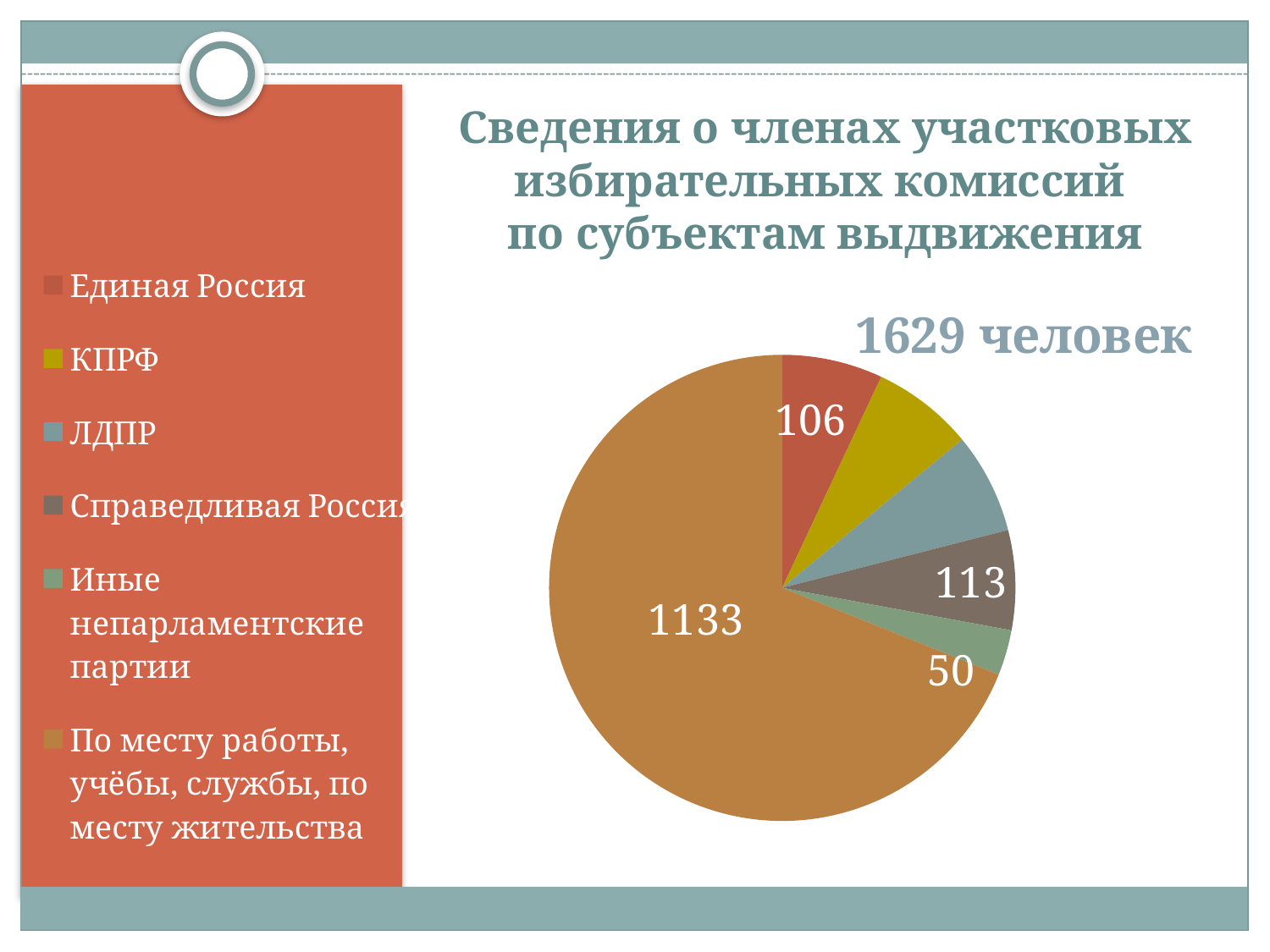
What is the value for Единая Россия in the pie chart? 106 Which category has the largest slice in the pie chart? По месту работы, учёбы, службы, по месту жительства Which is larger: the value for Единая Россия or the value for Иные непарламентские партии? Единая Россия Which category has the smallest slice in the pie chart? Иные непарламентские партии What colour is the slice for КПРФ in the pie chart? yellow What is the value for Справедливая Россия in the pie chart? 113 What total number of people is stated next to the pie chart? 1629 человек What type of chart is shown on the slide? pie chart What is the value for По месту работы, учёбы, службы, по месту жительства in the pie chart? 1133 What is the value for Иные непарламентские партии in the pie chart? 50 How many categories does the legend of the pie chart list? 6 What is the difference between the values for Справедливая Россия and Единая Россия? 7